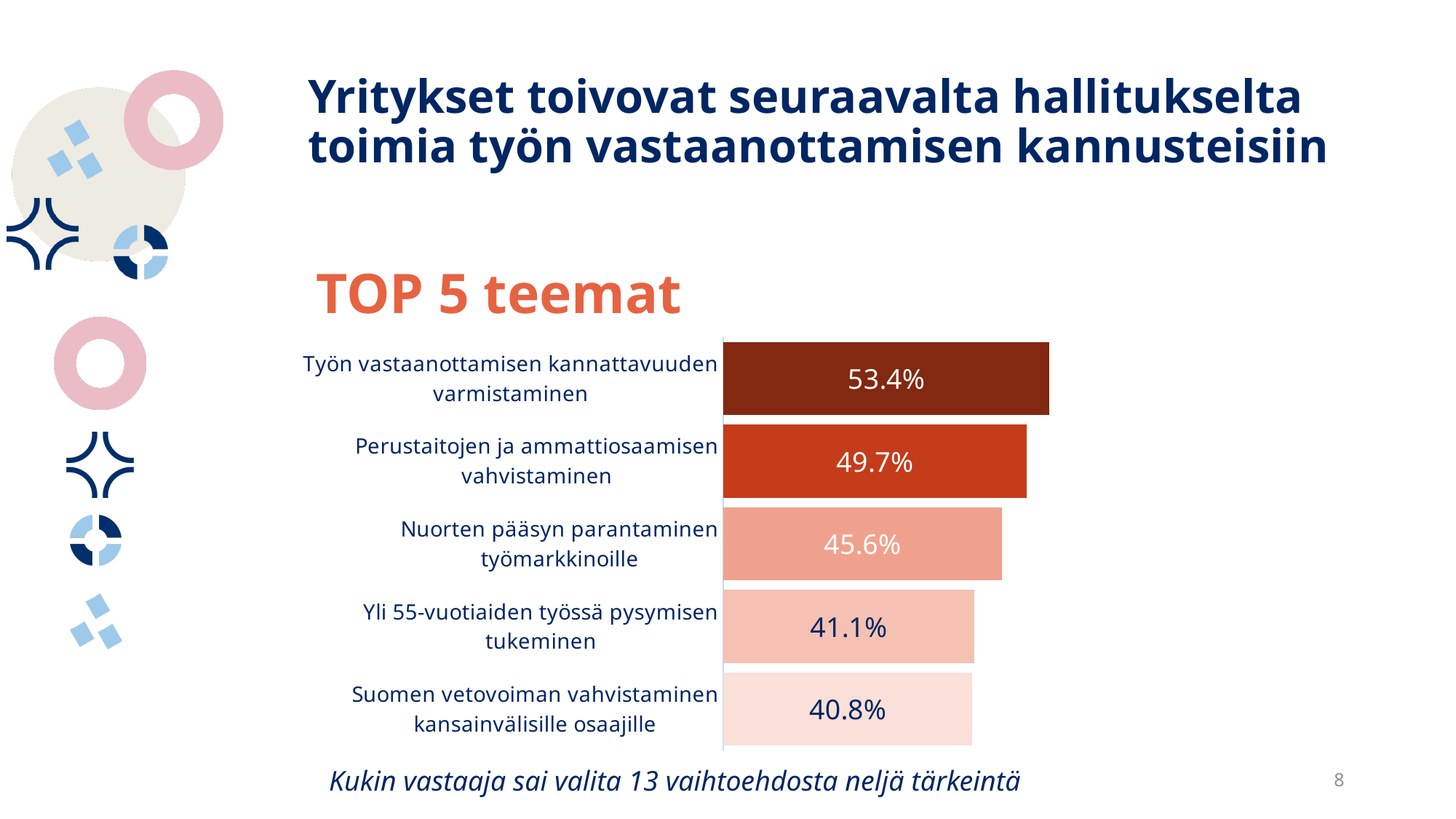
What is the value for "Suomen vetovoiman vahvistaminen kansainvälisille osaajille"? 40.8% Which is larger: the value for "Perustaitojen ja ammattiosaamisen vahvistaminen" or "Nuorten pääsyn parantaminen työmarkkinoille"? Perustaitojen ja ammattiosaamisen vahvistaminen What is the value for "Yli 55-vuotiaiden työssä pysymisen tukeminen"? 41.1% Which category has the highest value? Työn vastaanottamisen kannattavuuden varmistaminen What is the value for "Nuorten pääsyn parantaminen työmarkkinoille"? 45.6% What is the difference between the values for "Työn vastaanottamisen kannattavuuden varmistaminen" and "Perustaitojen ja ammattiosaamisen vahvistaminen"? 3.7% What is the value for "Työn vastaanottamisen kannattavuuden varmistaminen"? 53.4% How many categories are shown in the chart? 5 Which category has the lowest value? Suomen vetovoiman vahvistaminen kansainvälisille osaajille What kind of chart is shown on the slide? Bar chart What is the value for "Perustaitojen ja ammattiosaamisen vahvistaminen"? 49.7% What is the difference between the values for "Nuorten pääsyn parantaminen työmarkkinoille" and "Suomen vetovoiman vahvistaminen kansainvälisille osaajille"? 4.8%